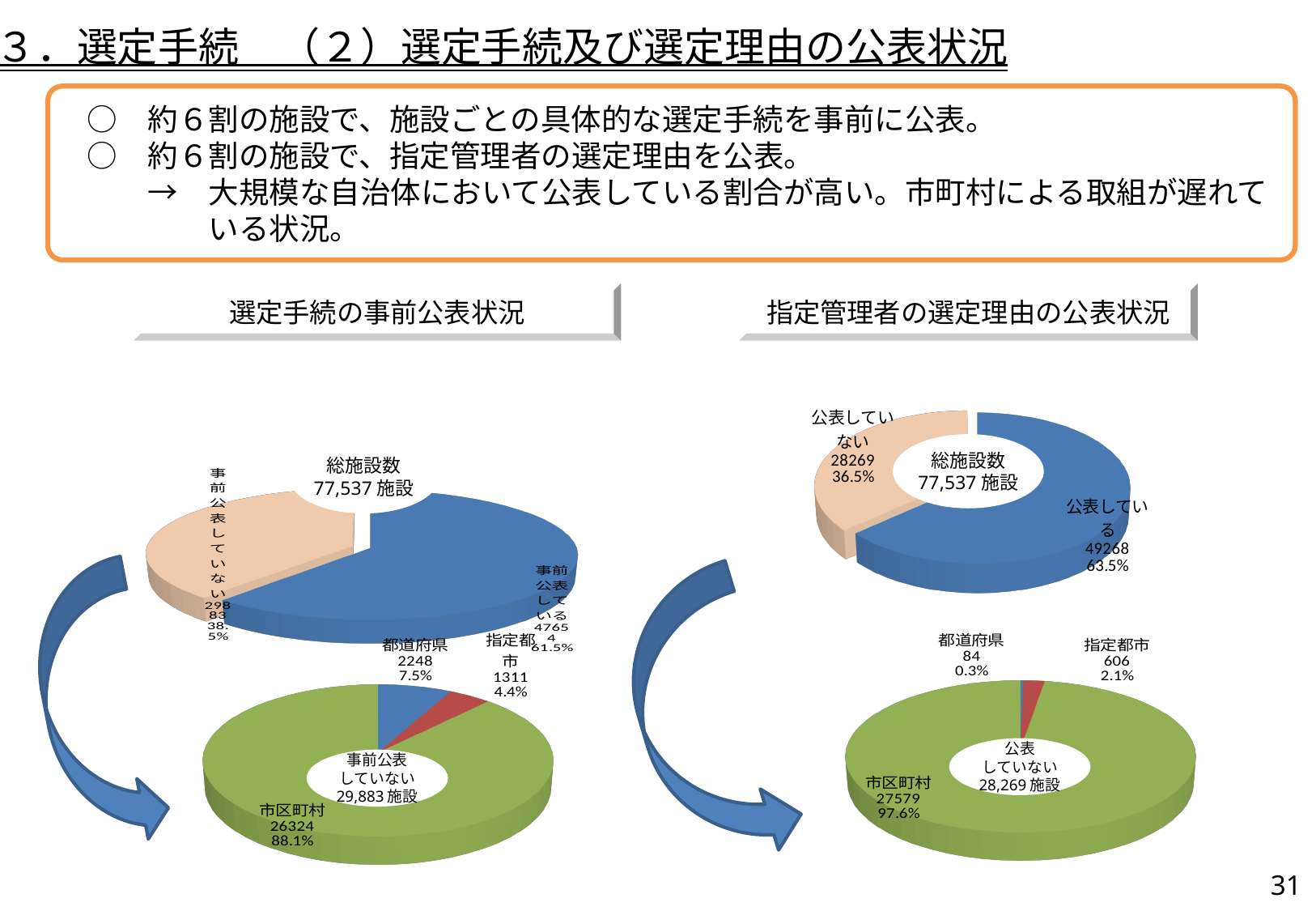
In the bottom-right doughnut chart (公表していない 28,269 施設), how many categories are shown? 3 In the top-left pie chart under 選定手続の事前公表状況, how many facilities are labelled 事前公表していない? 29883 In the top-right doughnut chart under 指定管理者の選定理由の公表状況, how many facilities are labelled 公表していない? 28269 In the bottom-left doughnut chart (事前公表していない 29,883 施設), what is the value for 市区町村? 26324 In the top-left pie chart under 選定手続の事前公表状況, what percentage of facilities are labelled 事前公表している? 61.5% In the top-right doughnut chart under 指定管理者の選定理由の公表状況, what percentage of facilities are labelled 公表している? 63.5% In the bottom-right doughnut chart (公表していない 28,269 施設), which is larger, 都道府県 or 指定都市? 指定都市 In the bottom-right doughnut chart (公表していない 28,269 施設), what percentage is 市区町村? 97.6% What kind of chart is the top-left chart under 選定手続の事前公表状況? Pie chart In the bottom-left doughnut chart (事前公表していない 29,883 施設), which category has the smallest share? 指定都市 What total number of facilities is shown in the centre of the top-right doughnut chart? 77,537 施設 In the bottom-left doughnut chart (事前公表していない 29,883 施設), what is the difference between the 都道府県 and 指定都市 values? 937